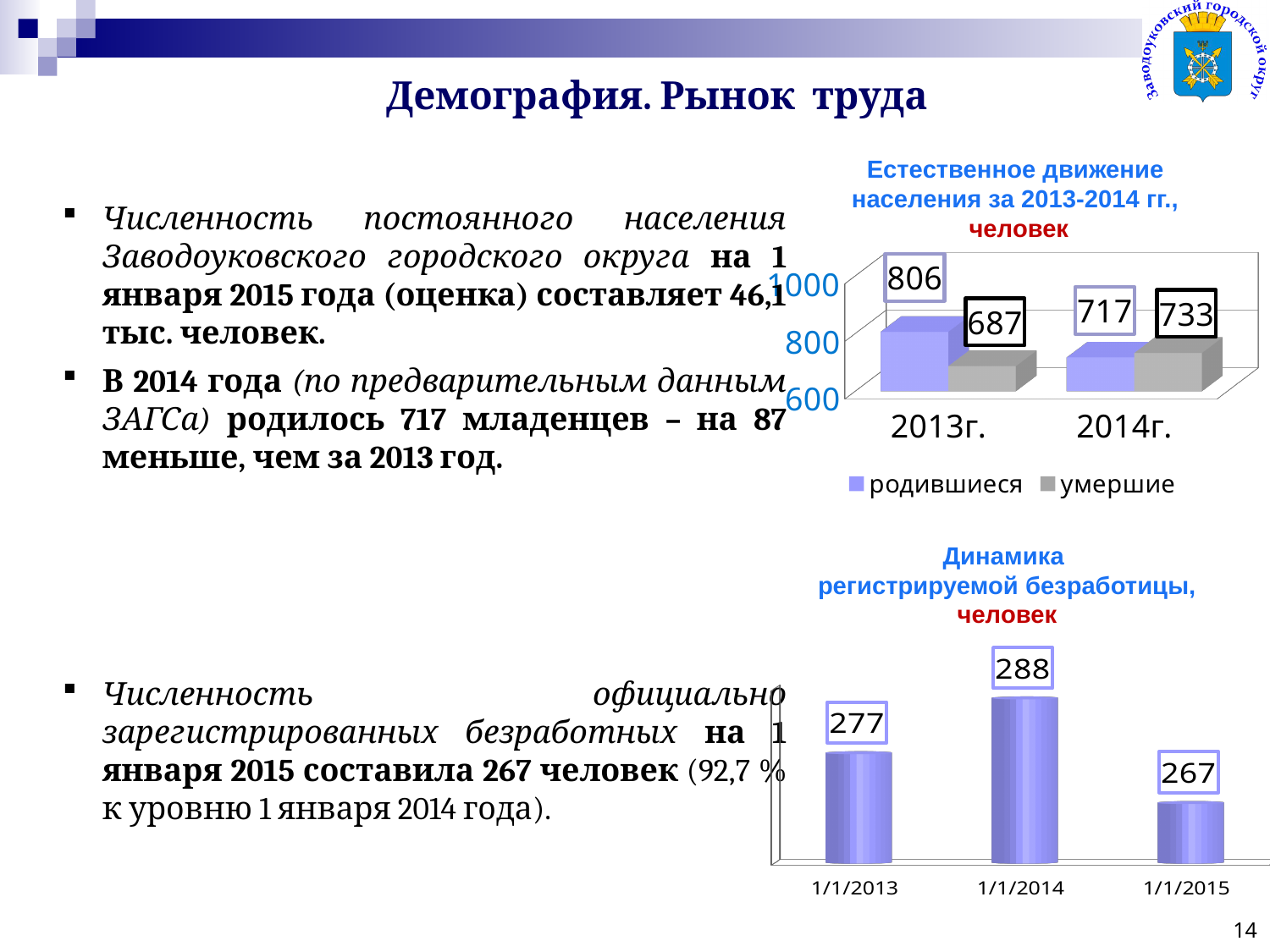
In the chart 'Естественное движение населения за 2013-2014 гг., человек', what is the value for умершие in 2014г.? 733 In the chart 'Естественное движение населения за 2013-2014 гг., человек', what is the difference between умершие in 2014г. and умершие in 2013г.? 46 What kind of chart is 'Динамика регистрируемой безработицы, человек'? bar chart In the chart 'Естественное движение населения за 2013-2014 гг., человек', what is the value for родившиеся in 2013г.? 806 In the chart 'Естественное движение населения за 2013-2014 гг., человек', how many series does the legend list? 2 In the chart 'Динамика регистрируемой безработицы, человек', which date has the lowest value? 1/1/2015 In the chart 'Естественное движение населения за 2013-2014 гг., человек', does the value for родившиеся rise or fall from 2013г. to 2014г.? fall In the chart 'Динамика регистрируемой безработицы, человек', what is the value for 1/1/2014? 288 In the chart 'Динамика регистрируемой безработицы, человек', what is the difference between the values for 1/1/2014 and 1/1/2015? 21 In the chart 'Естественное движение населения за 2013-2014 гг., человек', which is larger in 2014г., родившиеся or умершие? умершие In the chart 'Естественное движение населения за 2013-2014 гг., человек', what is the difference between родившиеся in 2013г. and родившиеся in 2014г.? 89 In the chart 'Динамика регистрируемой безработицы, человек', how many categories are shown on the x axis? 3